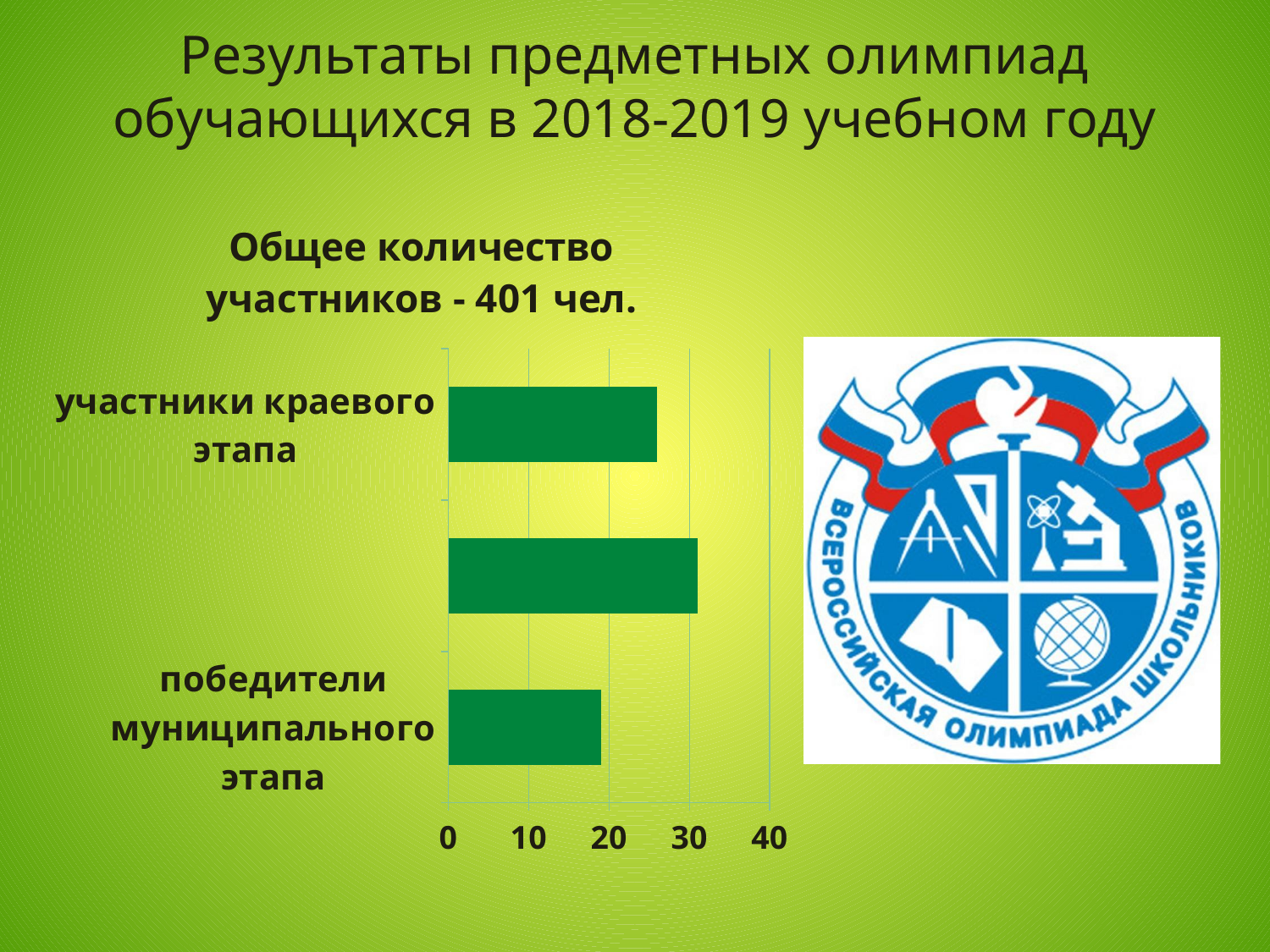
Which category has the lowest value in the chart? победители муниципального этапа Is the value for участники краевого этапа greater or less than 30? less Which is larger: the value for участники краевого этапа or the value for победители муниципального этапа? участники краевого этапа Is the value for победители муниципального этапа greater or less than 10? greater Is the value for участники краевого этапа greater or less than 20? greater What kind of chart is shown on the slide? bar chart What is the title of the chart? Общее количество участников - 401 чел. What is the highest value shown on the horizontal axis of the chart? 40 How many bars does the chart contain? 3